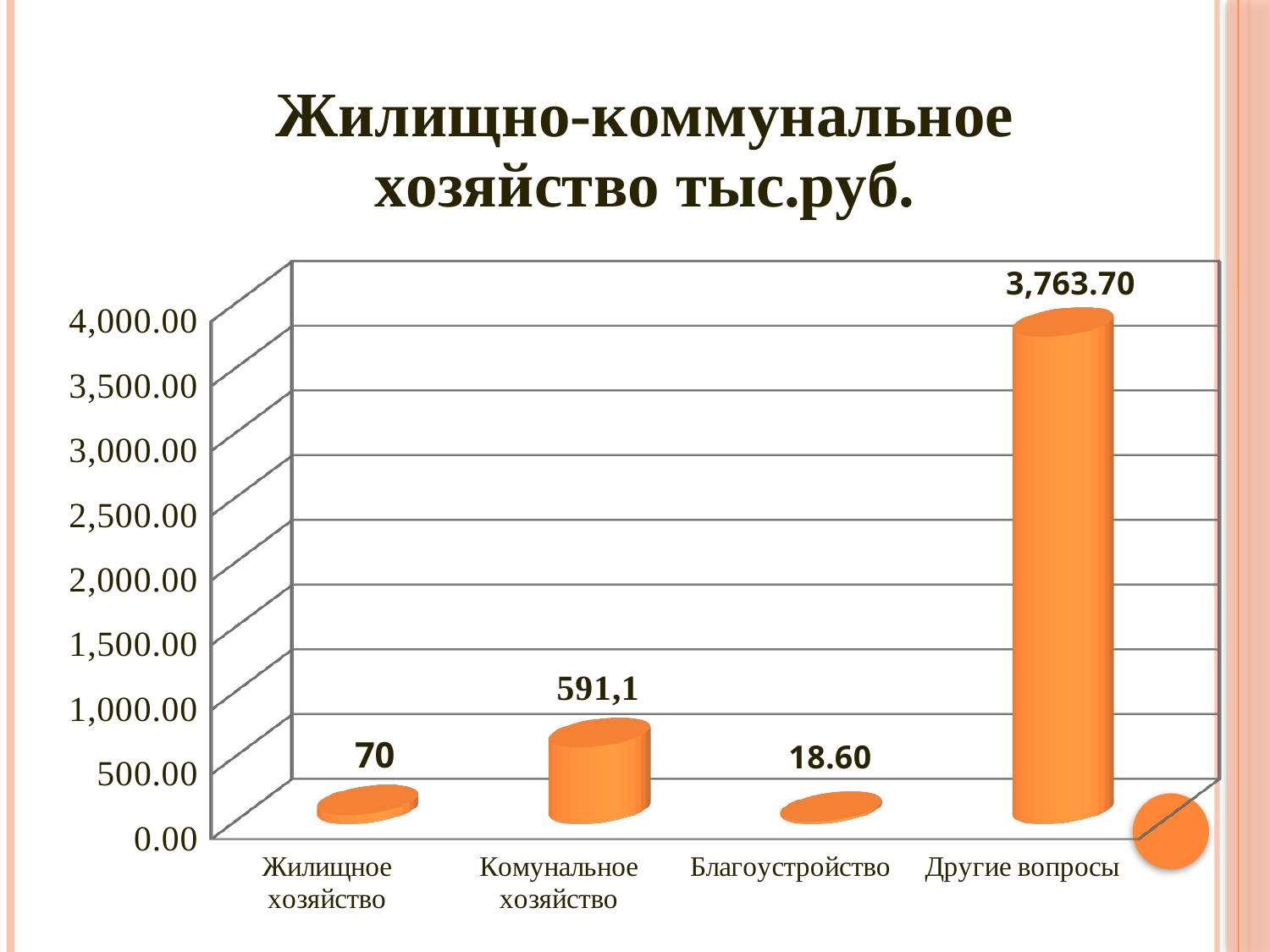
What is the difference between the values for Жилищное хозяйство and Благоустройство? 51.40 What kind of chart is shown on the slide? Bar chart What is the value for Комунальное хозяйство? 591,1 Is the value for Другие вопросы greater or less than 3,500.00? greater What is the title of the chart? Жилищно-коммунальное хозяйство тыс.руб. What is the value for Благоустройство? 18.60 Which is larger, Жилищное хозяйство or Комунальное хозяйство? Комунальное хозяйство What is the value for Жилищное хозяйство? 70 Which category has the lowest value? Благоустройство What is the value for Другие вопросы? 3,763.70 Is the value for Комунальное хозяйство greater or less than 1,000.00? less Which category has the highest value? Другие вопросы